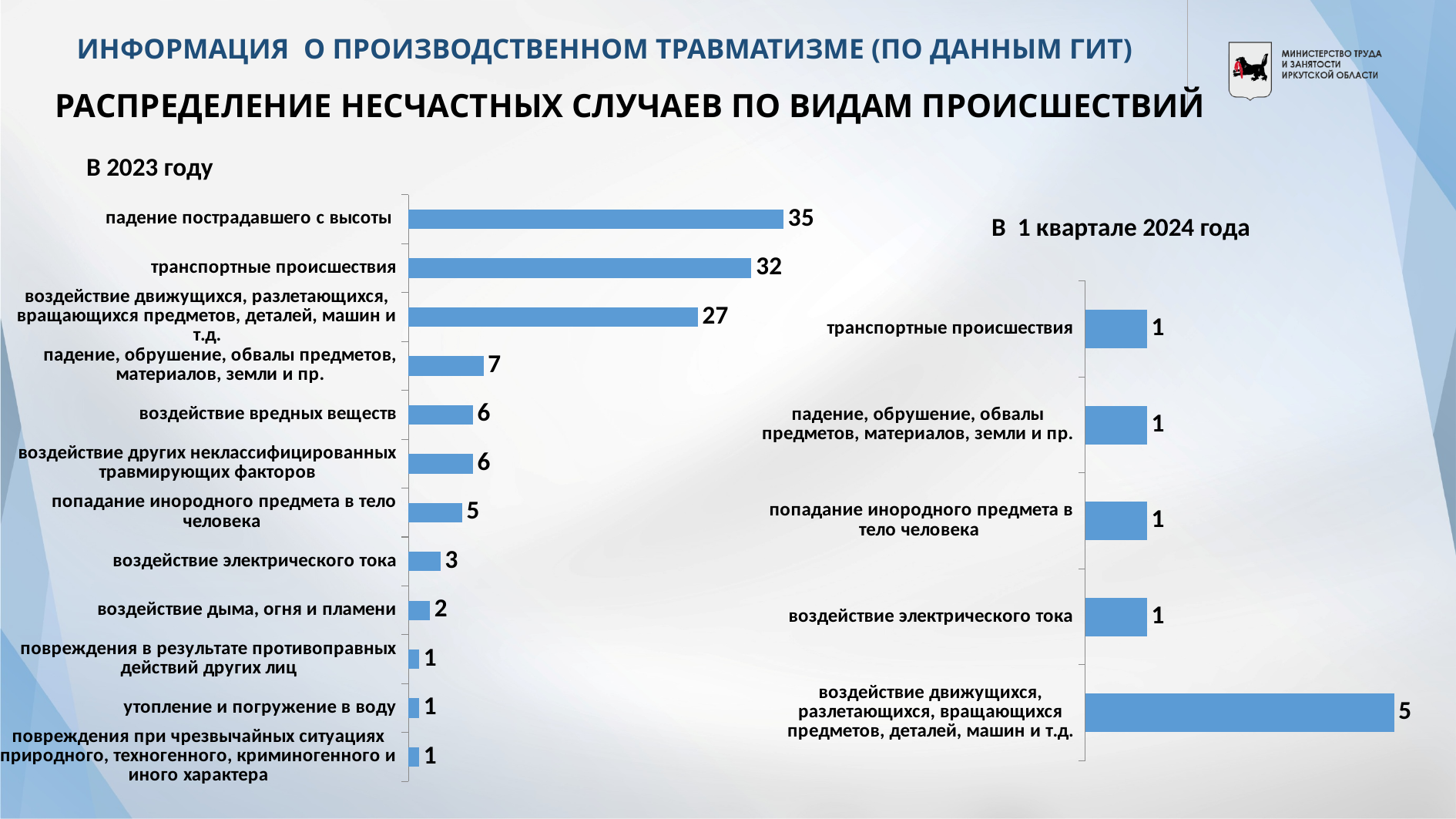
In the chart 'В 2023 году', what is the difference between 'падение пострадавшего с высоты' and 'транспортные происшествия'? 3 In the chart 'В 2023 году', which is larger: 'воздействие электрического тока' or 'воздействие дыма, огня и пламени'? воздействие электрического тока In the chart 'В 2023 году', how many categories are shown? 12 In the chart 'В 1 квартале 2024 года', what is the value for 'транспортные происшествия'? 1 In the chart 'В 1 квартале 2024 года', what is the difference between 'воздействие движущихся, разлетающихся, вращающихся предметов, деталей, машин и т.д.' and 'воздействие электрического тока'? 4 What kind of chart is 'В 1 квартале 2024 года'? bar chart In the chart 'В 2023 году', which category has the highest value? падение пострадавшего с высоты In the chart 'В 1 квартале 2024 года', which category has the highest value? воздействие движущихся, разлетающихся, вращающихся предметов, деталей, машин и т.д. In the chart 'В 2023 году', what is the value for 'попадание инородного предмета в тело человека'? 5 In the chart 'В 2023 году', what is the value for 'падение пострадавшего с высоты'? 35 In the chart 'В 1 квартале 2024 года', how many categories are shown? 5 In the chart 'В 2023 году', what is the value for 'транспортные происшествия'? 32